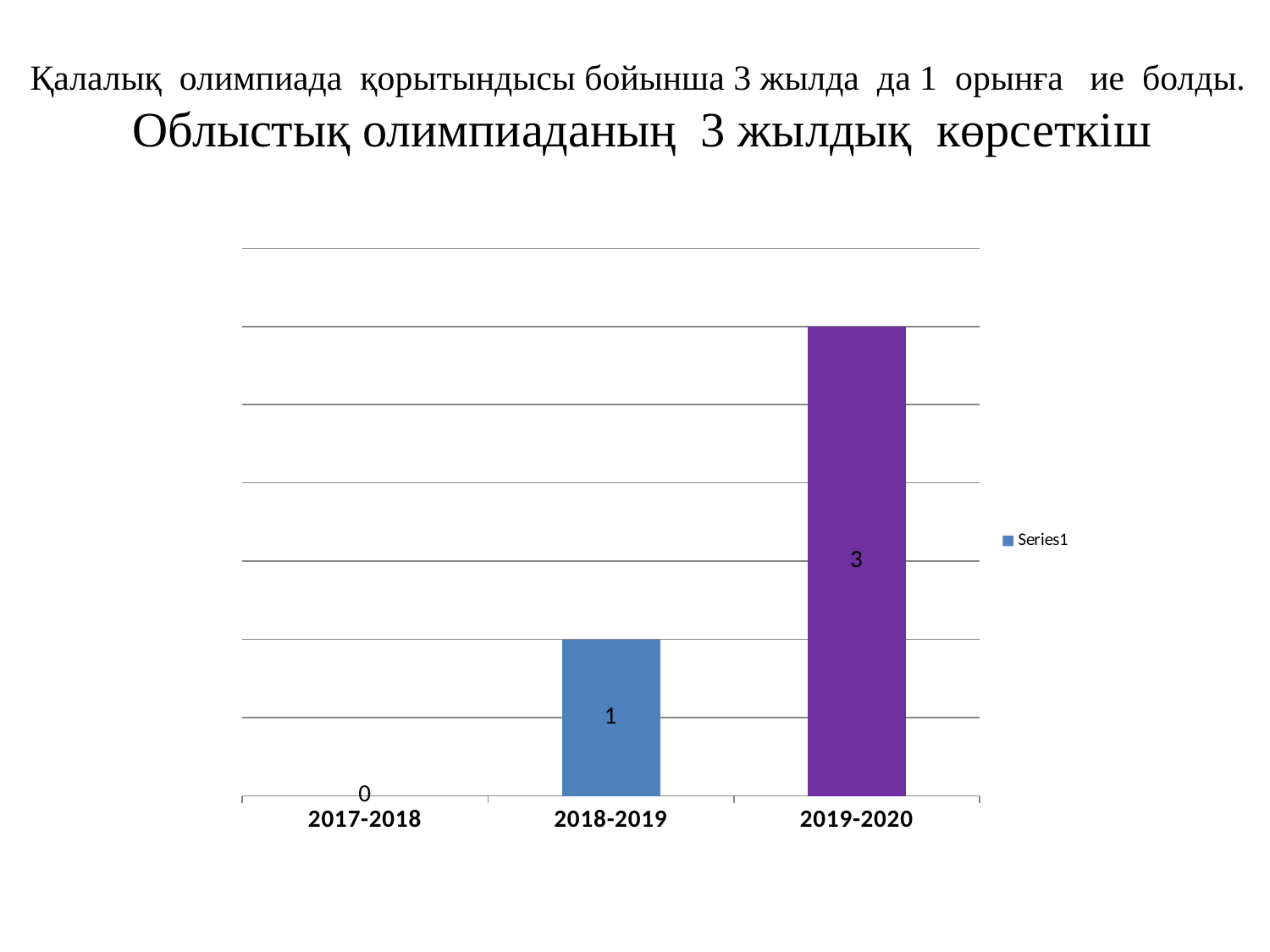
Which is larger, the value for 2018-2019 or the value for 2019-2020? 2019-2020 How many series does the legend list? 1 Do the values rise or fall from 2017-2018 to 2019-2020? rise Which year has the highest value? 2019-2020 What is the name of the series listed in the legend? Series1 What is the value for 2017-2018? 0 What is the value for 2018-2019? 1 Which year has the lowest value? 2017-2018 What kind of chart is shown on the slide? bar chart What is the value for 2019-2020? 3 How many categories are shown on the x axis? 3 What is the difference between the values for 2019-2020 and 2018-2019? 2